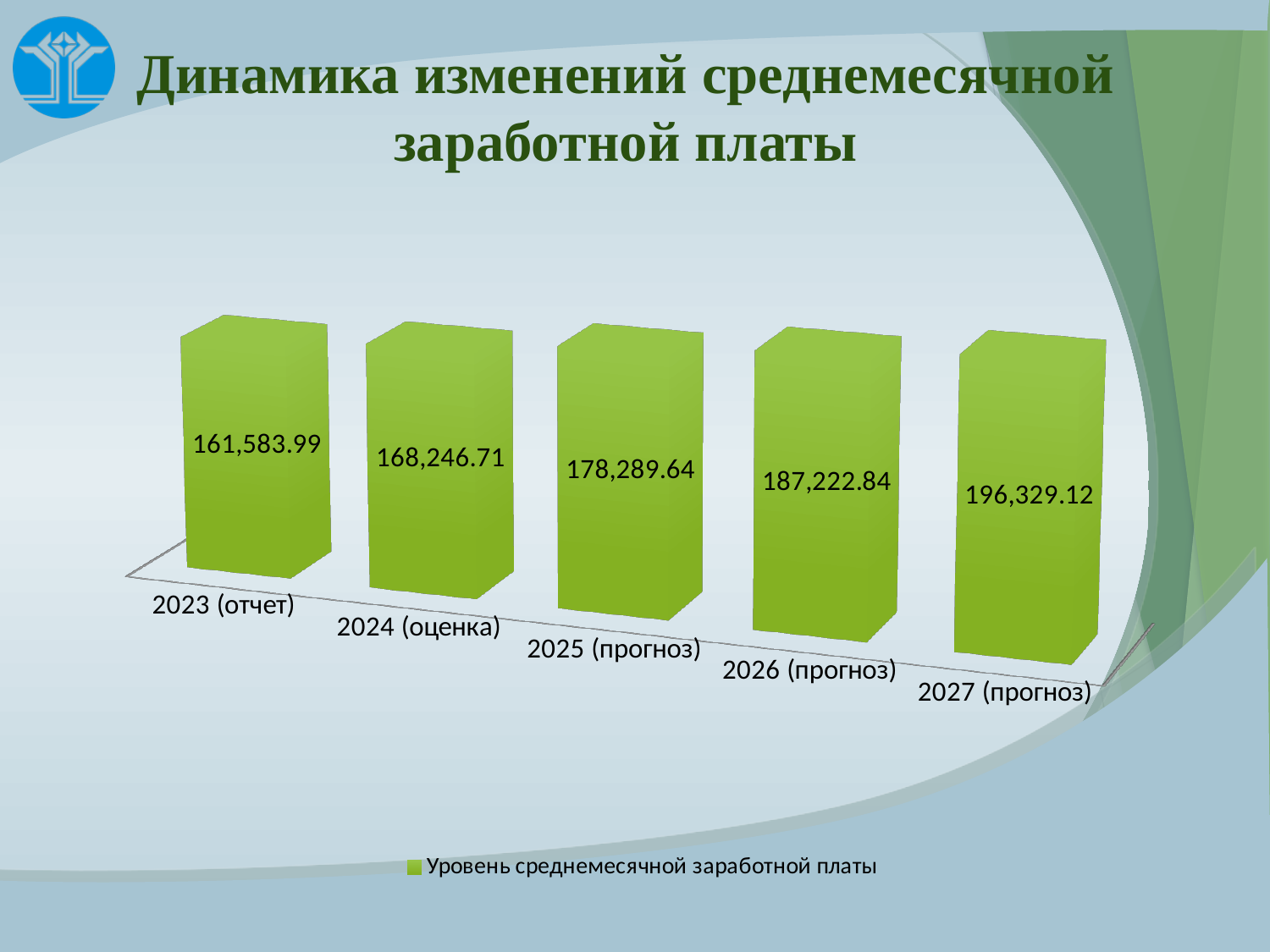
Which is larger, the value for 2026 (прогноз) or the value for 2024 (оценка)? 2026 (прогноз) What kind of chart is shown on the slide? bar chart Which category has the highest value? 2027 (прогноз) Do the values rise or fall from 2023 (отчет) to 2027 (прогноз)? rise How many series does the legend list? 1 Which category has the lowest value? 2023 (отчет) What is the value for 2027 (прогноз)? 196,329.12 How many categories are shown on the chart? 5 What is the value for 2025 (прогноз)? 178,289.64 What is the value for 2023 (отчет)? 161,583.99 What is the difference between the values for 2027 (прогноз) and 2023 (отчет)? 34,745.13 What is the difference between the values for 2025 (прогноз) and 2024 (оценка)? 10,042.93